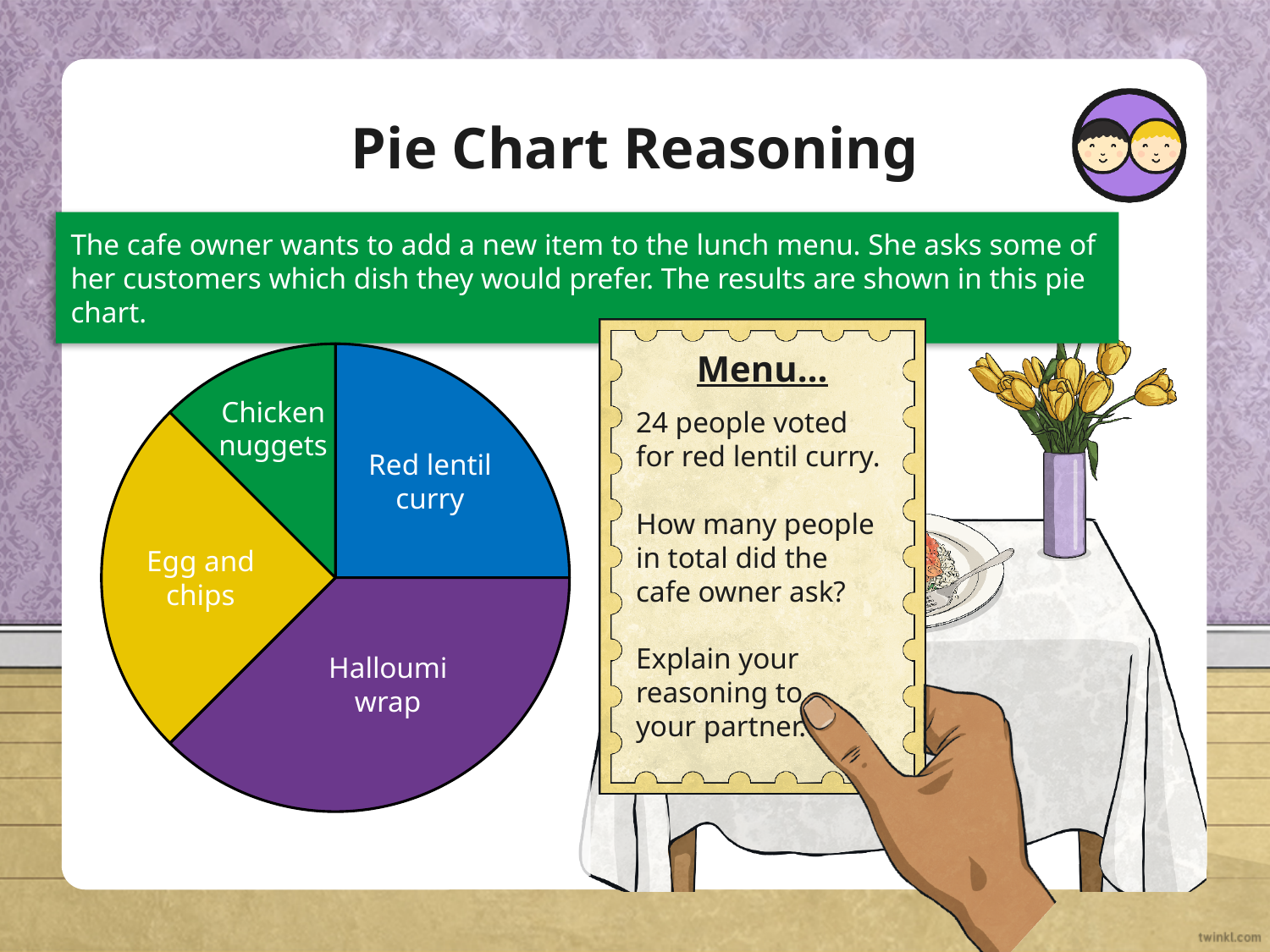
Which slice is larger, Halloumi wrap or Red lentil curry? Halloumi wrap Which dish is shown by the yellow slice of the pie chart? Egg and chips According to the slide, how many people voted for red lentil curry? 24 Which dish has the largest slice of the pie chart? Halloumi wrap What colour is the Red lentil curry slice in the pie chart? Blue What kind of chart is shown on the slide? Pie chart Which dish has the smallest slice of the pie chart? Chicken nuggets How many dishes (slices) are shown in the pie chart? 4 Which slice is larger, Egg and chips or Chicken nuggets? Egg and chips Which slice is larger, Halloumi wrap or Chicken nuggets? Halloumi wrap